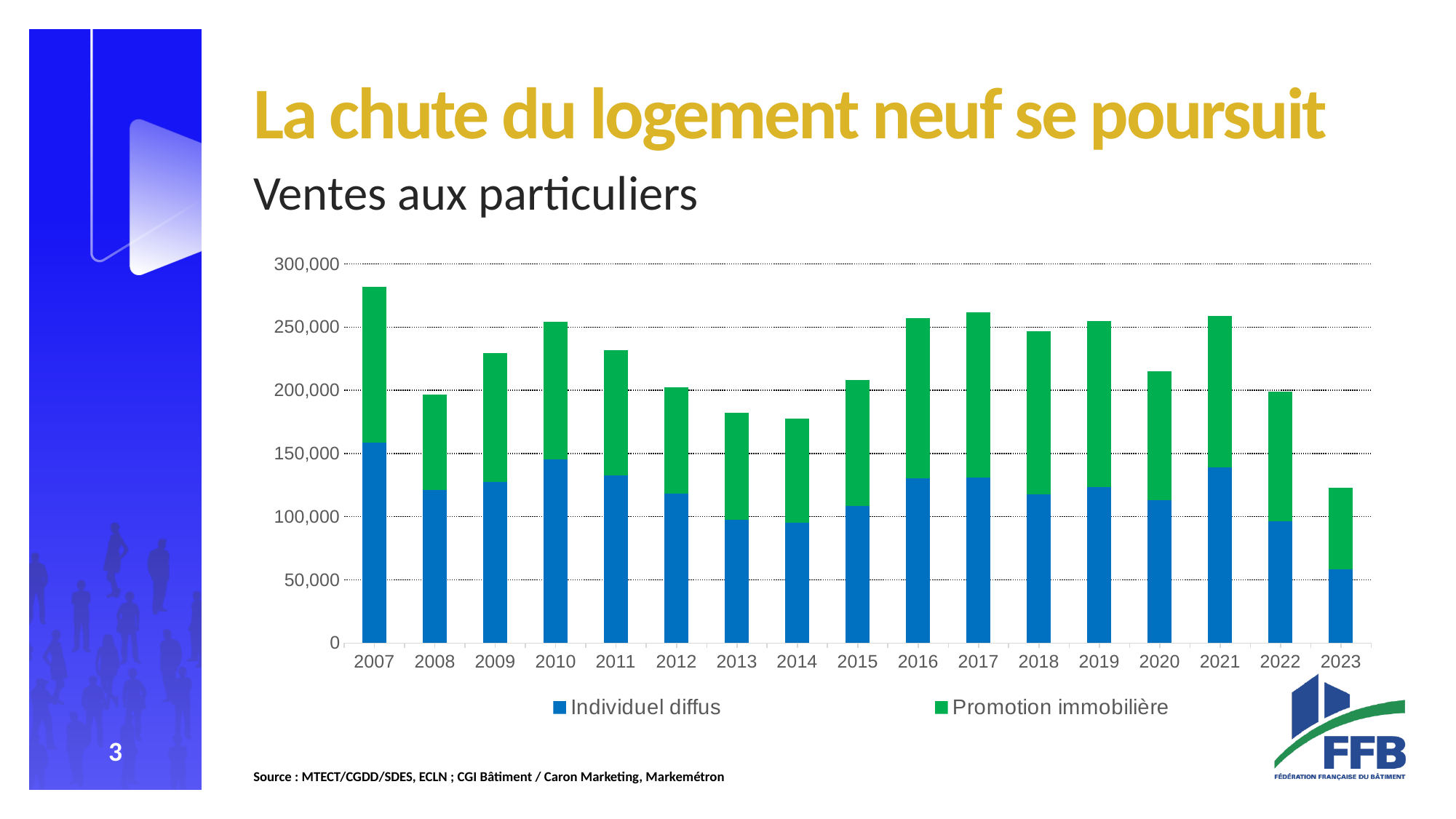
What kind of chart is shown on the slide? Stacked bar chart Is the total bar for 2014 greater or less than 200,000? less How many years are shown on the x axis of the chart? 17 Is the total bar for 2007 greater or less than 250,000? greater How many series does the chart legend list? 2 Which colour represents the Promotion immobilière series in the chart? Green Which year has the highest total bar in the chart? 2007 From 2021 to 2023, do the total bars rise or fall? fall Is the Individuel diffus value for 2007 greater or less than 150,000? greater Which year has the lowest total bar in the chart? 2023 Which year has the larger total bar, 2010 or 2008? 2010